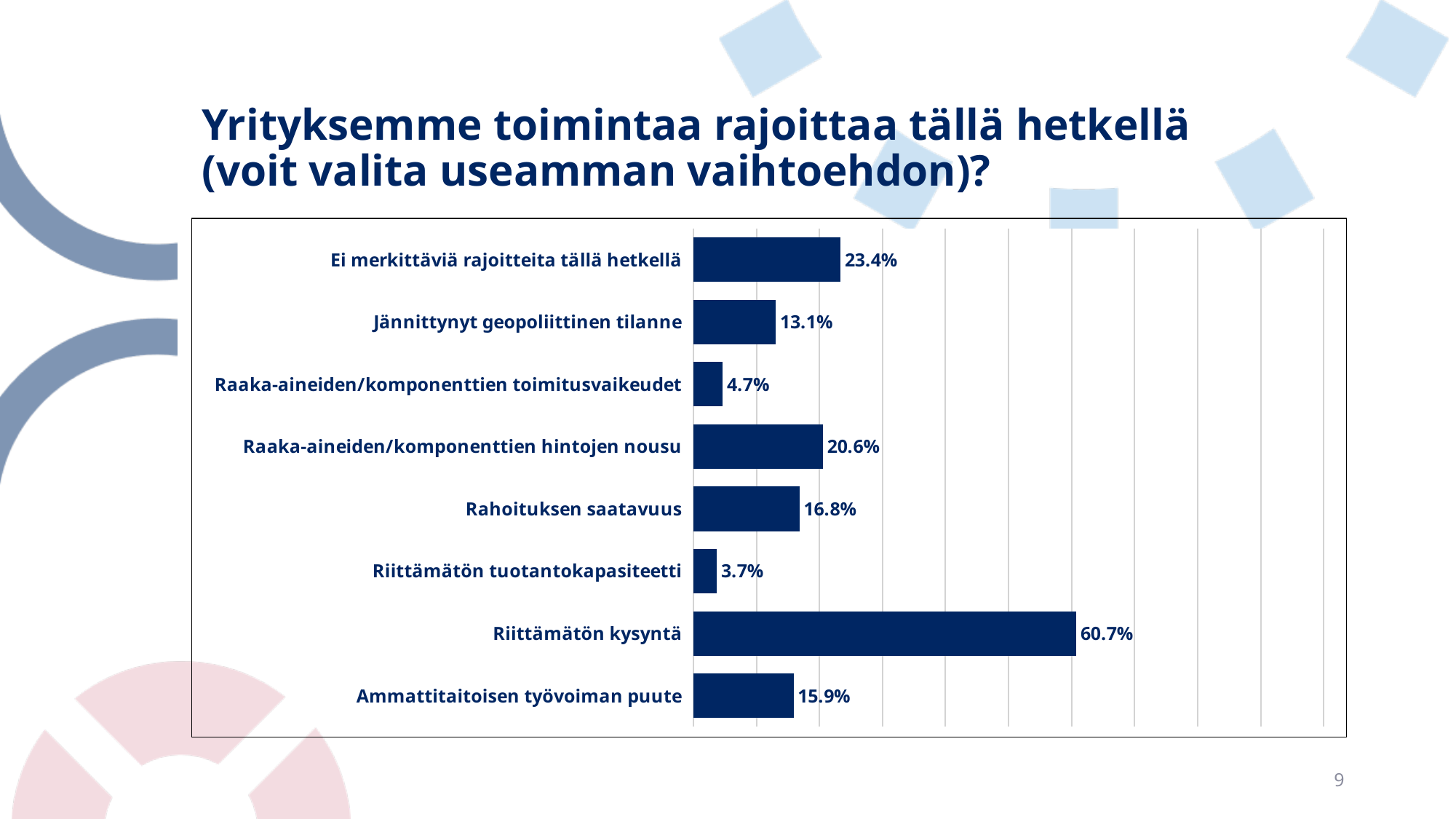
What is the value for Riittämätön kysyntä? 60.7% Which category has the lowest value? Riittämätön tuotantokapasiteetti What is the title of the slide? Yrityksemme toimintaa rajoittaa tällä hetkellä (voit valita useamman vaihtoehdon)? What is the value for Ammattitaitoisen työvoiman puute? 15.9% Which is larger, the value for Jännittynyt geopoliittinen tilanne or the value for Ammattitaitoisen työvoiman puute? Ammattitaitoisen työvoiman puute What is the value for Rahoituksen saatavuus? 16.8% What is the value for Raaka-aineiden/komponenttien hintojen nousu? 20.6% What is the difference between the values for Riittämätön kysyntä and Ei merkittäviä rajoitteita tällä hetkellä? 37.3 percentage points How many categories are shown in the chart? 8 What kind of chart is shown on the slide? Bar chart What is the difference between the values for Raaka-aineiden/komponenttien hintojen nousu and Rahoituksen saatavuus? 3.8 percentage points Which category has the highest value? Riittämätön kysyntä